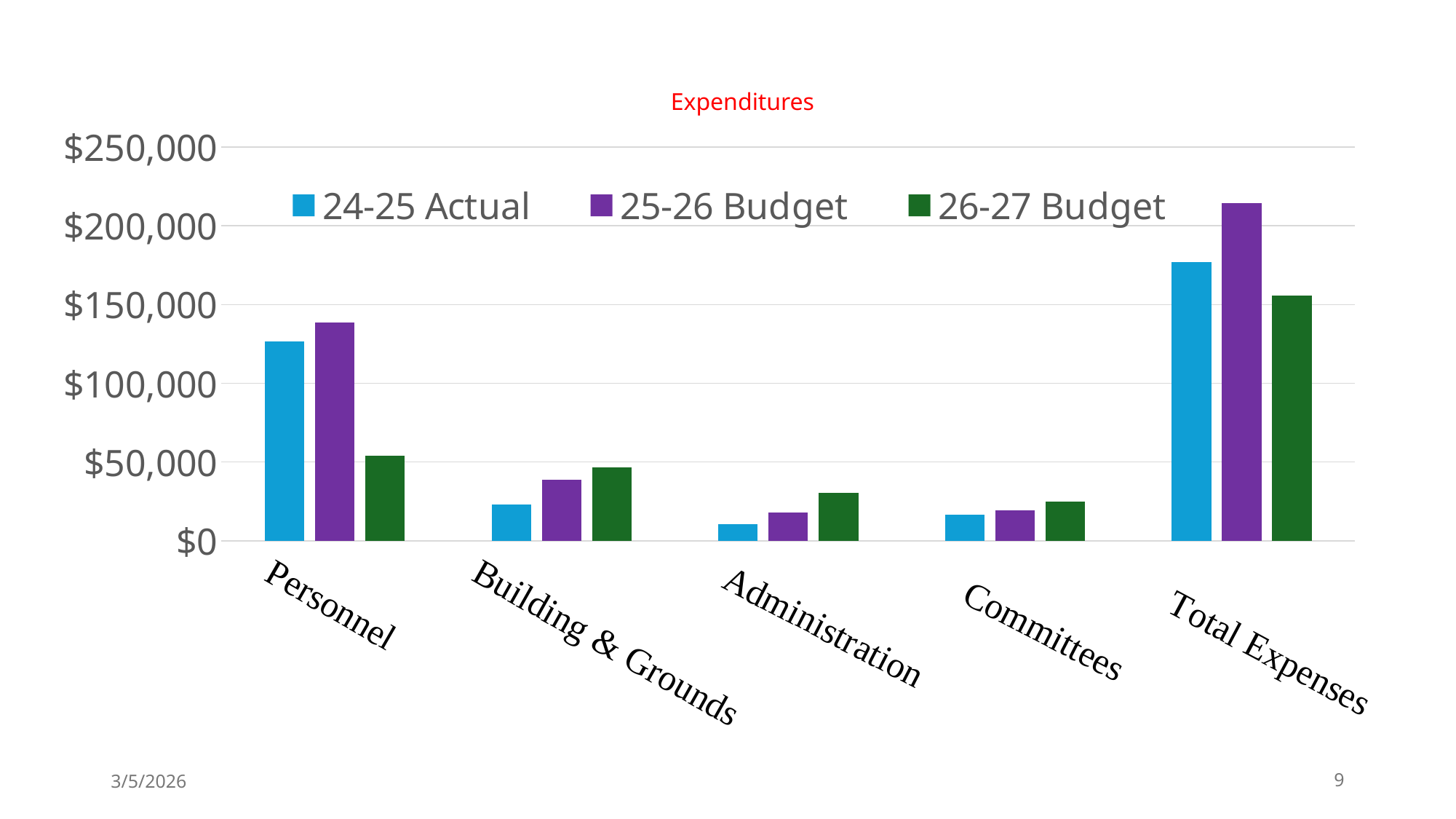
What is the title of the chart? Expenditures For Building & Grounds, which is larger: the 24-25 Actual value or the 26-27 Budget value? 26-27 Budget For Personnel, which is larger: the 24-25 Actual value or the 26-27 Budget value? 24-25 Actual Which category has the lowest 24-25 Actual value? Administration Is the 26-27 Budget value for Personnel greater or less than $100,000? less Which category has the highest 25-26 Budget value? Total Expenses How many series does the legend list? 3 What kind of chart is shown on the slide? Bar chart Is the 26-27 Budget value for Total Expenses greater or less than $200,000? less Is the 25-26 Budget value for Personnel greater or less than $100,000? greater How many categories are shown on the x axis? 5